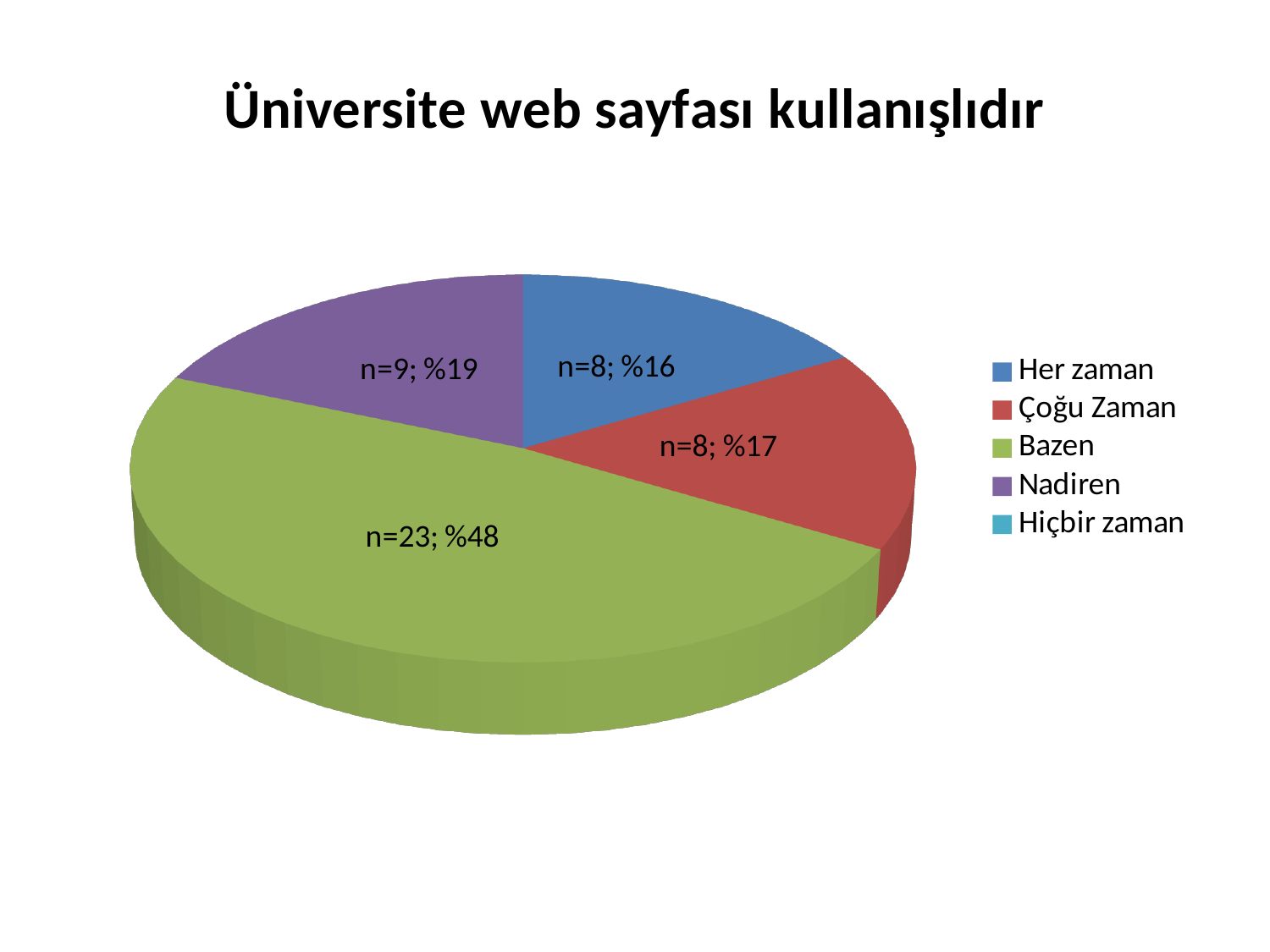
What percentage share does the Çoğu Zaman slice have? %17 What is the data label for the Nadiren slice? n=9; %19 What is the data label for the Her zaman slice? n=8; %16 What kind of chart is shown on the slide? pie chart How many entries does the legend list? 5 Which is larger, the Nadiren slice or the Her zaman slice? Nadiren What is the difference in percentage between the Bazen slice and the Çoğu Zaman slice? 31 percentage points What is the title of the chart? Üniversite web sayfası kullanışlıdır What is the difference in n between the Bazen slice and the Nadiren slice? 14 What is the data label for the Bazen slice? n=23; %48 Which category has the largest slice of the pie? Bazen What colour is the Bazen slice? green